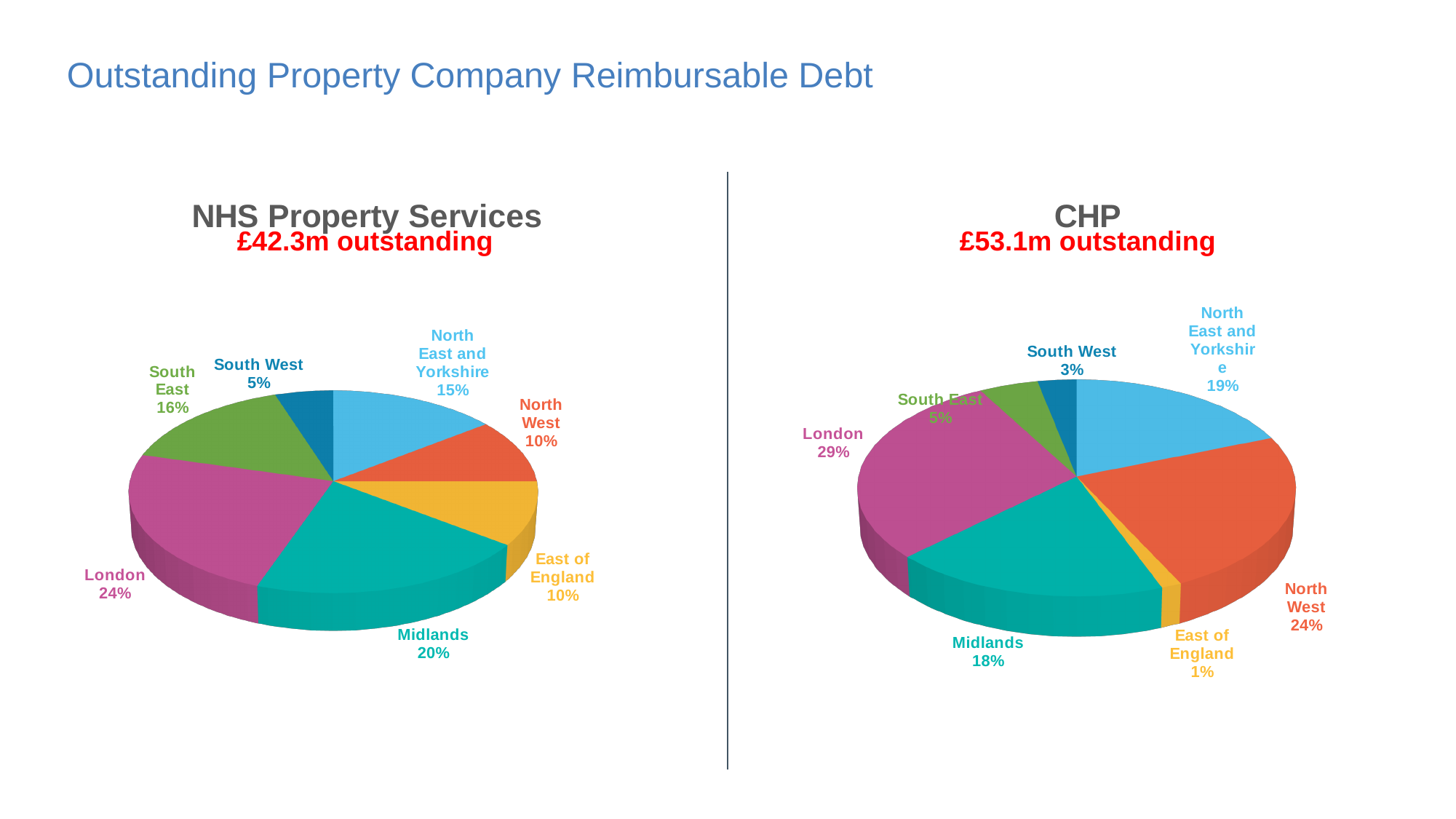
In the NHS Property Services pie chart, what share does East of England have? 10% How many slices does the NHS Property Services pie chart have? 7 In the NHS Property Services pie chart, what share does London have? 24% In the CHP pie chart, which is larger, the share for Midlands or the share for North East and Yorkshire? North East and Yorkshire In the NHS Property Services pie chart, what is the difference between the Midlands share and the South East share? 4% In the CHP pie chart, what share does North West have? 24% What kind of chart is used for CHP? Pie chart In the CHP pie chart, which region has the smallest share? East of England What is the total outstanding amount shown for NHS Property Services? £42.3m outstanding What is the total outstanding amount shown for CHP? £53.1m outstanding In the NHS Property Services pie chart, which region has the smallest share? South West In the CHP pie chart, which region has the largest share? London